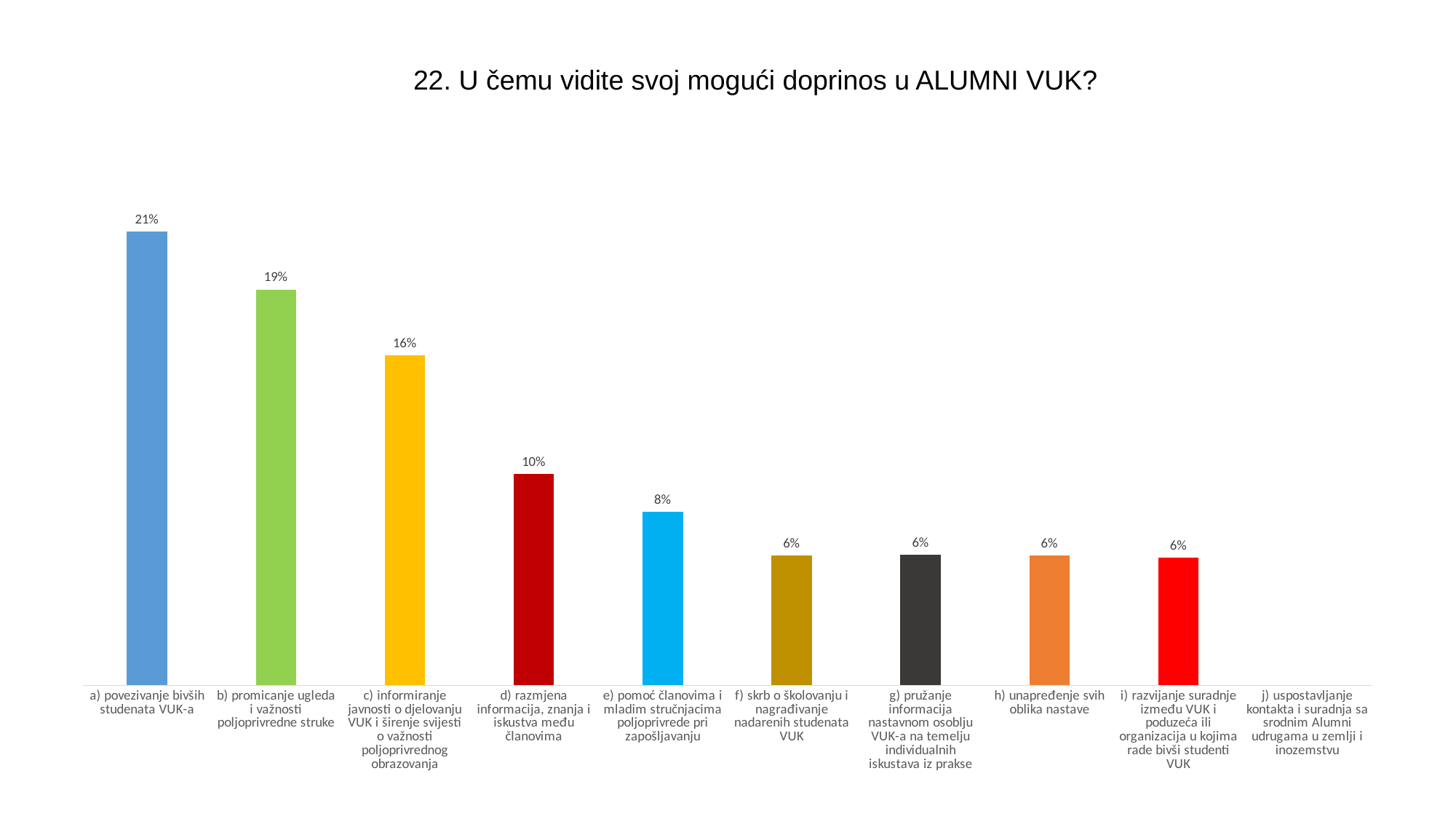
What is the value for "e) pomoć članovima i mladim stručnjacima poljoprivrede pri zapošljavanju"? 8% What is the difference between the values for "a) povezivanje bivših studenata VUK-a" and "b) promicanje ugleda i važnosti poljoprivredne struke"? 2% What is the title of the chart? 22. U čemu vidite svoj mogući doprinos u ALUMNI VUK? Do the values generally rise or fall from left to right along the x axis? fall What is the value for "h) unapređenje svih oblika nastave"? 6% What kind of chart is shown on the slide? bar chart What is the value for "c) informiranje javnosti o djelovanju VUK i širenje svijesti o važnosti poljoprivrednog obrazovanja"? 16% Which category has the highest value? a) povezivanje bivših studenata VUK-a What is the value for "a) povezivanje bivših studenata VUK-a"? 21% Which is larger, the value for "d) razmjena informacija, znanja i iskustva među članovima" or the value for "e) pomoć članovima i mladim stručnjacima poljoprivrede pri zapošljavanju"? d) razmjena informacija, znanja i iskustva među članovima How many categories are shown on the x axis? 10 What is the difference between the values for "c) informiranje javnosti..." and "d) razmjena informacija, znanja i iskustva među članovima"? 6%